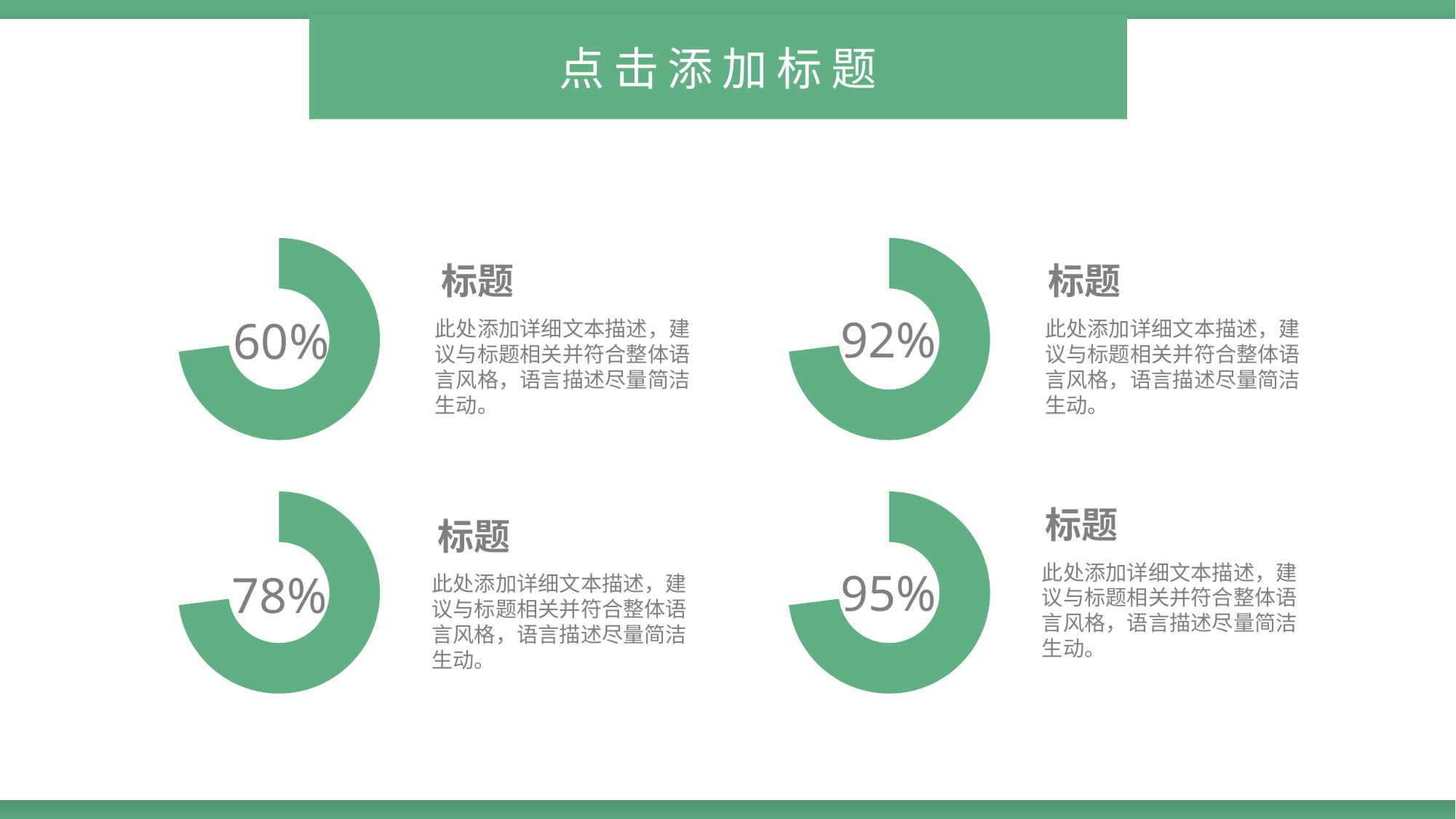
What percentage is shown in the bottom-right donut chart? 95% What is the difference between the percentages in the top-right and top-left donut charts? 32% What kind of chart is used to display the percentages on the slide? donut chart Which of the four donut charts shows the highest percentage? bottom-right (95%) What percentage is shown in the top-right donut chart? 92% What is the difference between the percentages in the bottom-right and bottom-left donut charts? 17% What percentage is shown in the top-left donut chart? 60% Which of the four donut charts shows the lowest percentage? top-left (60%) What percentage is shown in the bottom-left donut chart? 78% Which is larger, the percentage in the bottom-left donut chart or the top-right donut chart? top-right (92%) How many donut charts are on the slide? 4 What colour is the filled portion of the donut charts? green